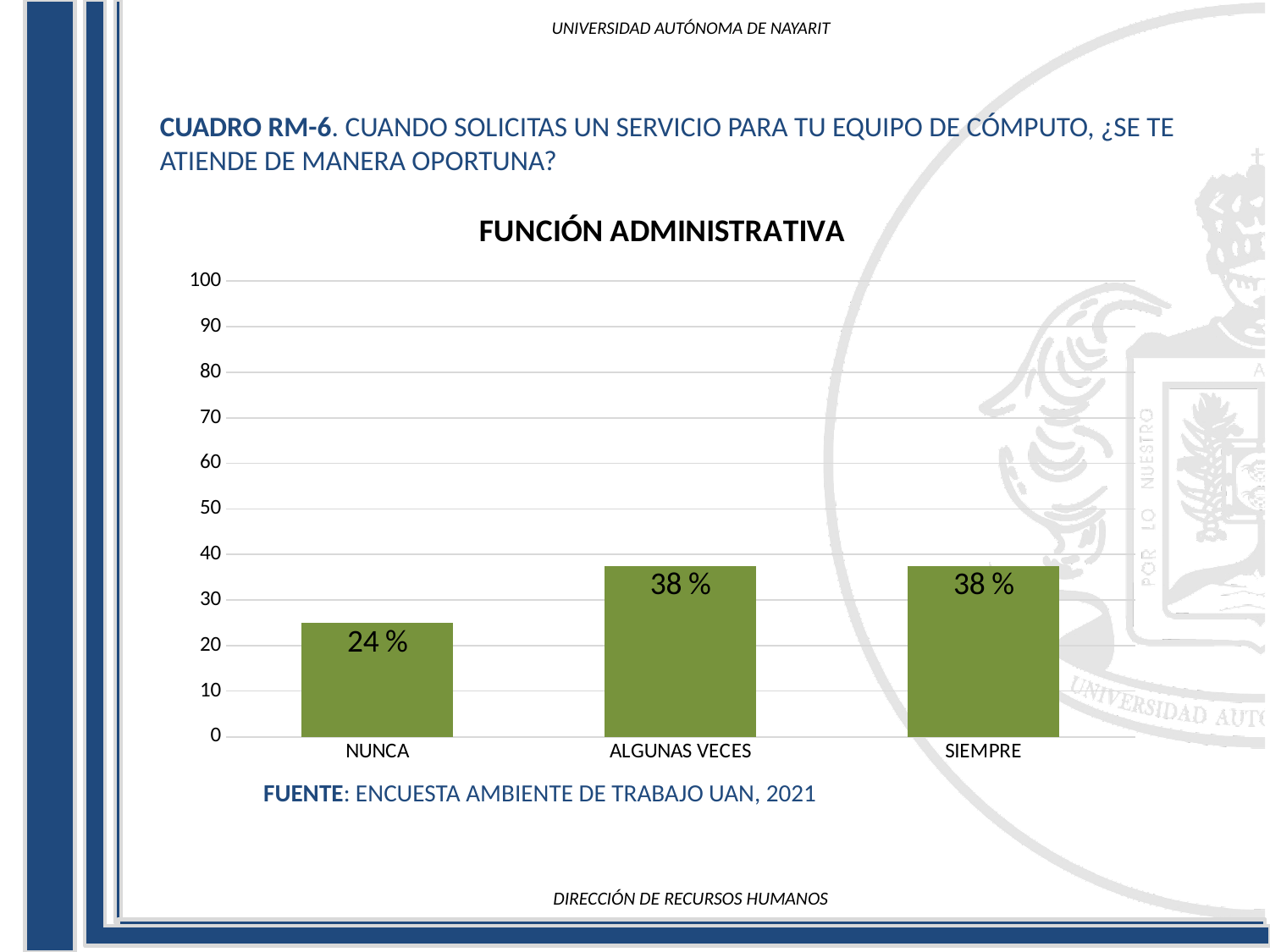
What is the title of the chart? FUNCIÓN ADMINISTRATIVA What is the highest value shown on the y axis? 100 Which is larger, the value for NUNCA or the value for SIEMPRE? SIEMPRE What is the difference between the values for ALGUNAS VECES and NUNCA? 14 % What is the value for ALGUNAS VECES? 38 % How many categories are shown on the x axis? 3 Which category has the lowest value? NUNCA What kind of chart is shown on the slide? bar chart Is the value for NUNCA greater or less than 30? less What is the value for SIEMPRE? 38 % What is the value for NUNCA? 24 % Is the value for SIEMPRE greater or less than 30? greater